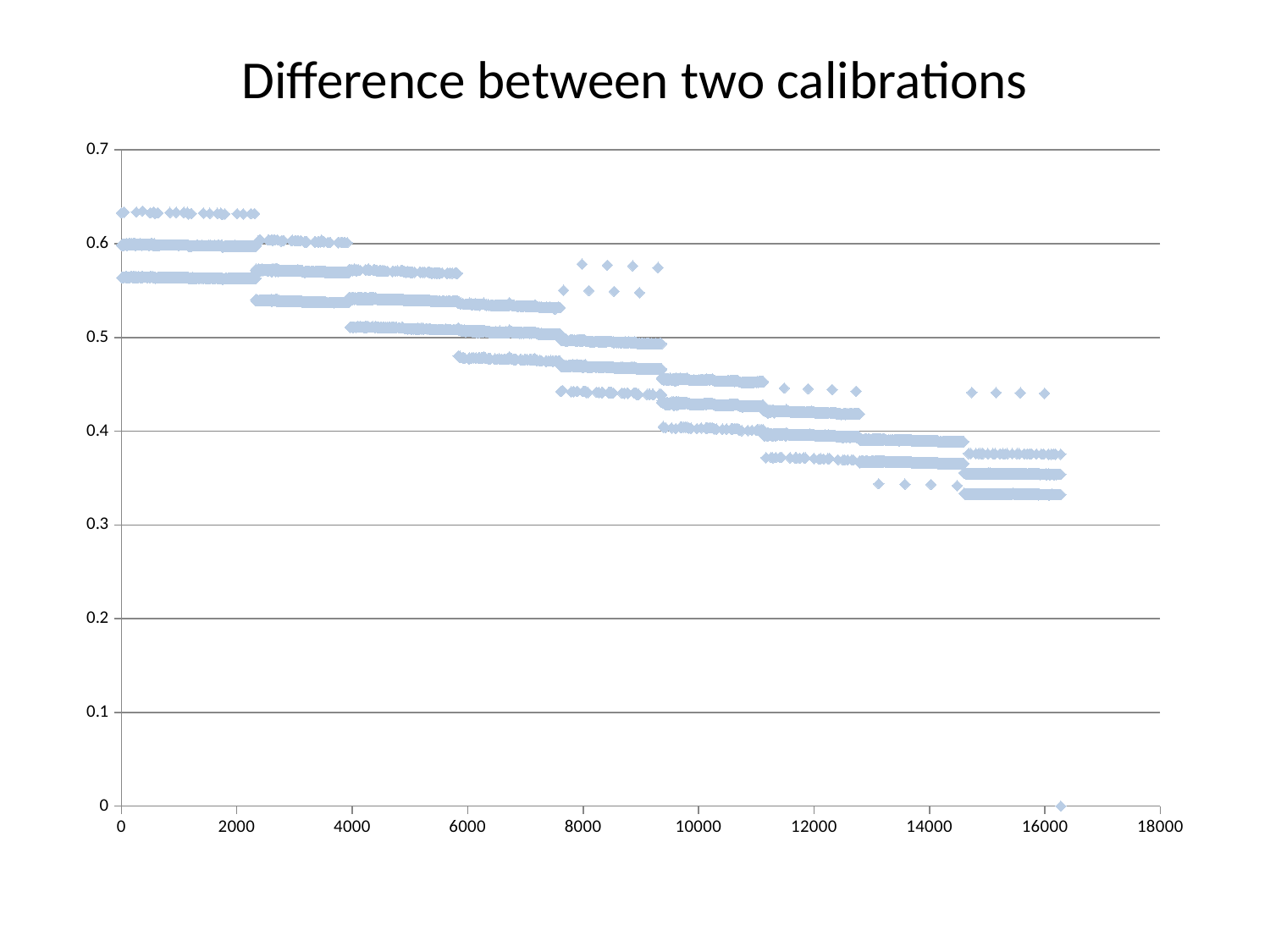
Which is larger: the plotted values near x = 1000 or the plotted values near x = 15000? the values near x = 1000 What is the maximum value shown on the y-axis? 0.7 Are the plotted values near x = 14000 greater or less than 0.3? greater What is the title of the chart? Difference between two calibrations Are the highest plotted values on the chart greater or less than 0.7? less Do the plotted values generally rise or fall as the x-axis value increases? fall What kind of chart is shown on the slide? scatter chart Are the plotted values near x = 10000 greater or less than 0.6? less